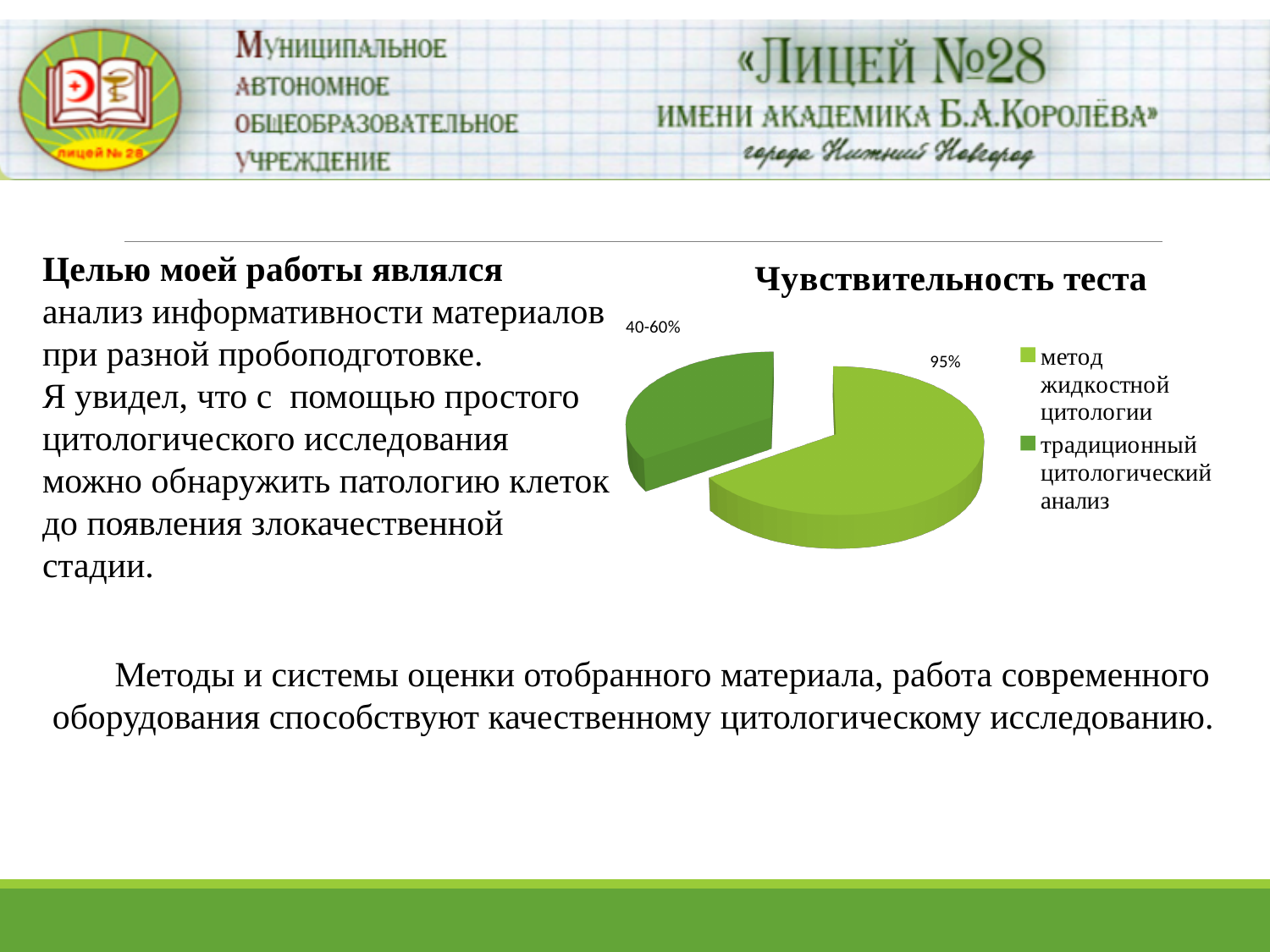
What value is labelled for традиционный цитологический анализ? 40-60% What kind of chart is shown on the slide? pie chart Which category has the largest slice of the pie? метод жидкостной цитологии How many slices does the pie chart have? 2 What value is labelled for метод жидкостной цитологии? 95% Which legend entry is shown in the darker green colour? традиционный цитологический анализ Which category has the smallest slice of the pie? традиционный цитологический анализ What is the title of the chart? Чувствительность теста Which slice is larger: метод жидкостной цитологии or традиционный цитологический анализ? метод жидкостной цитологии How many entries does the chart legend list? 2